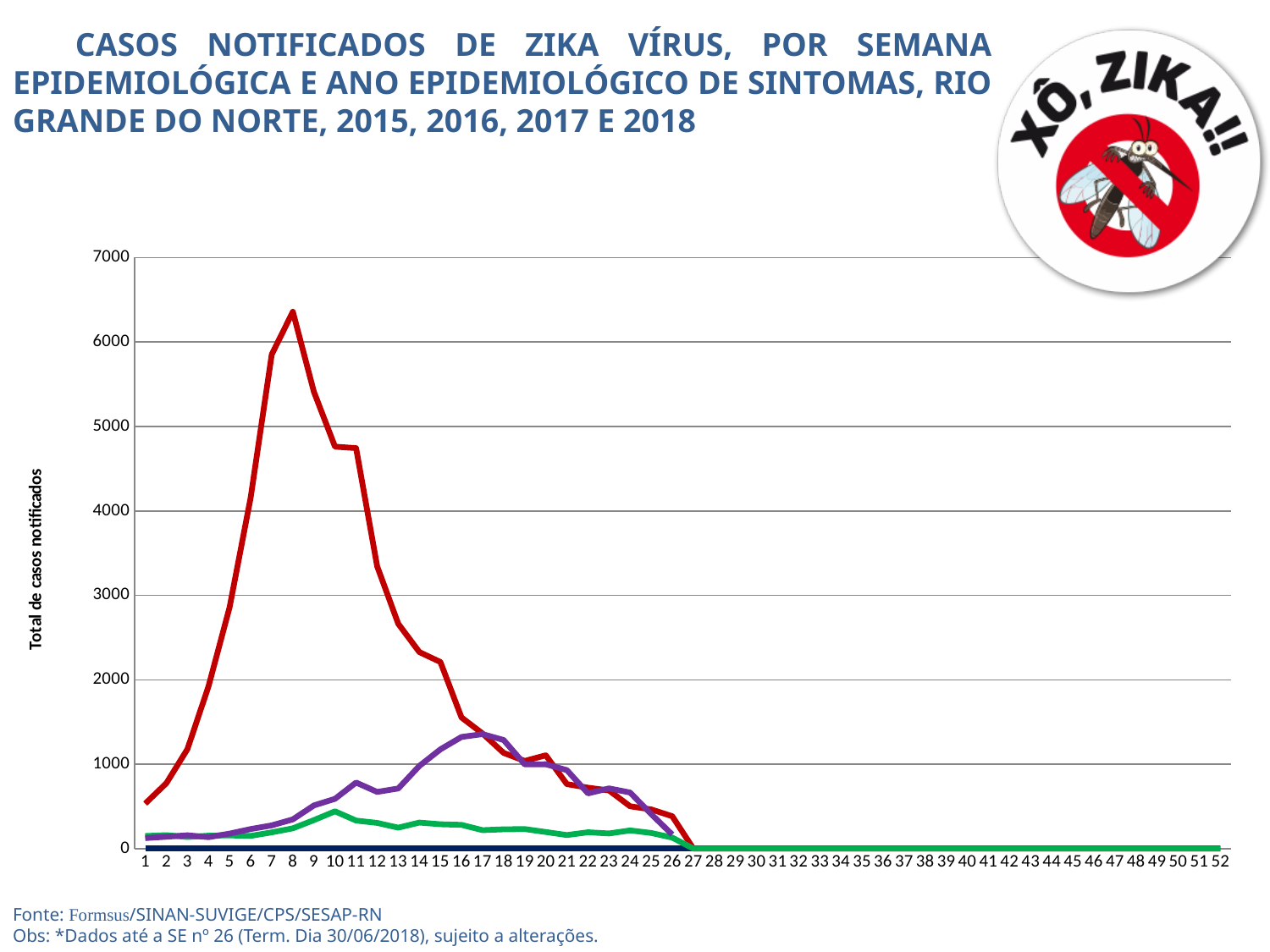
Is the value of the purple line at week 17 greater or less than 1000? greater How many epidemiological weeks are shown along the x axis? 52 Is the value of the green line at week 10 greater or less than 1000? less How many lines are plotted on the chart? 4 What kind of chart is shown on the slide? line chart Is the value of the red line at week 8 greater or less than 6000? greater Does the red line rise or fall from week 8 to week 27? fall At which epidemiological week does the red line reach its peak? 8 At week 8, which line is higher, the red line or the purple line? red What is the title of the y axis? Total de casos notificados